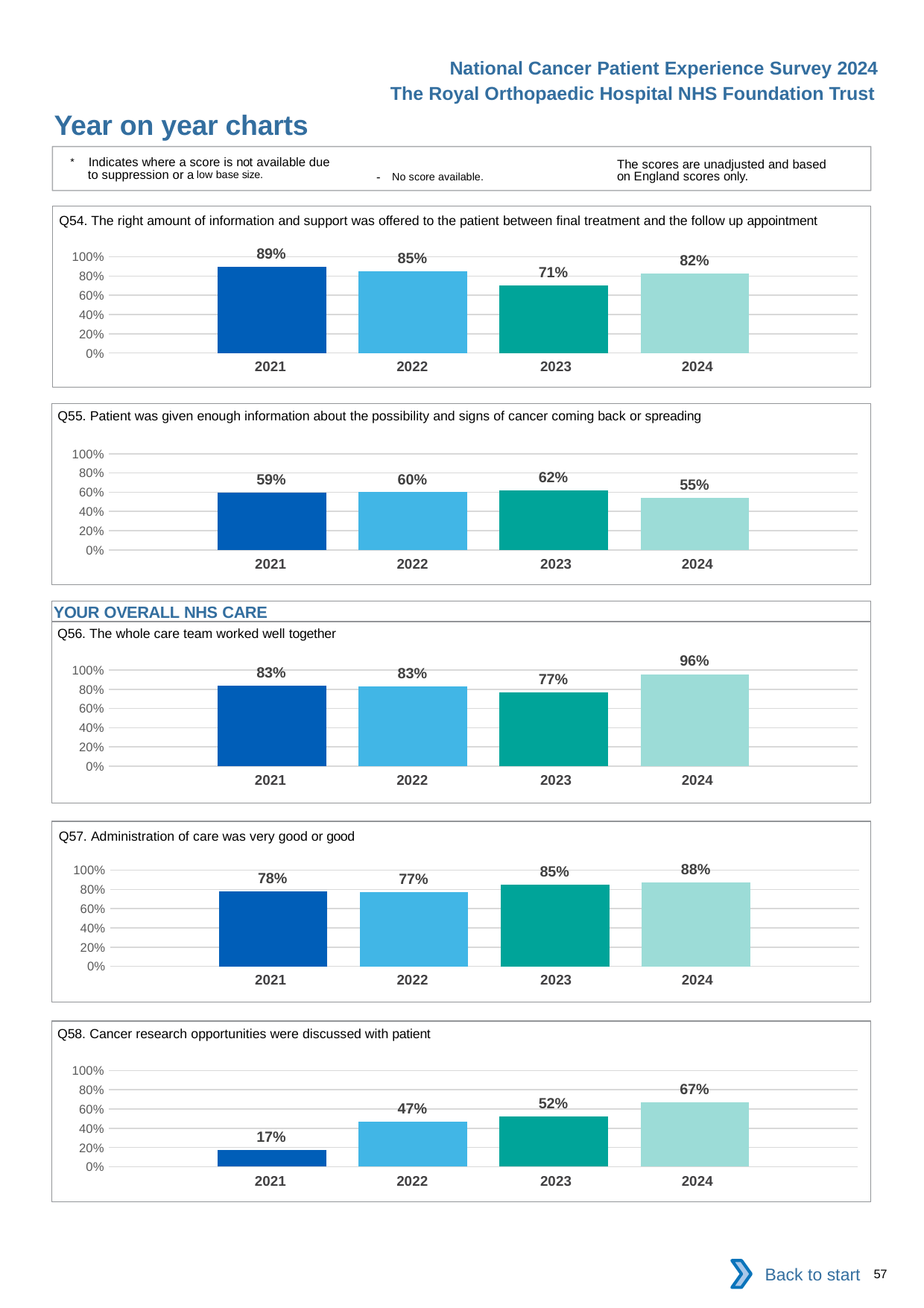
In the Q54 chart, what is the value for 2021? 89% In the Q58 chart, what is the value for 2021? 17% In the Q55 chart, which year has the highest value? 2023 In the Q58 chart, do the values rise or fall from 2021 to 2024? Rise In the Q56 chart, which year has the highest value? 2024 In the Q55 chart, what is the value for 2024? 55% What type of chart is used for Q54? Bar chart In the Q57 chart, is the value for 2024 larger than the value for 2021? Yes In the Q56 chart, what is the difference between the 2024 value and the 2023 value? 19 percentage points In the Q54 chart, which year has the lowest value? 2023 In the Q57 chart, what is the value for 2022? 77% How many years are shown in the Q58 chart? 4